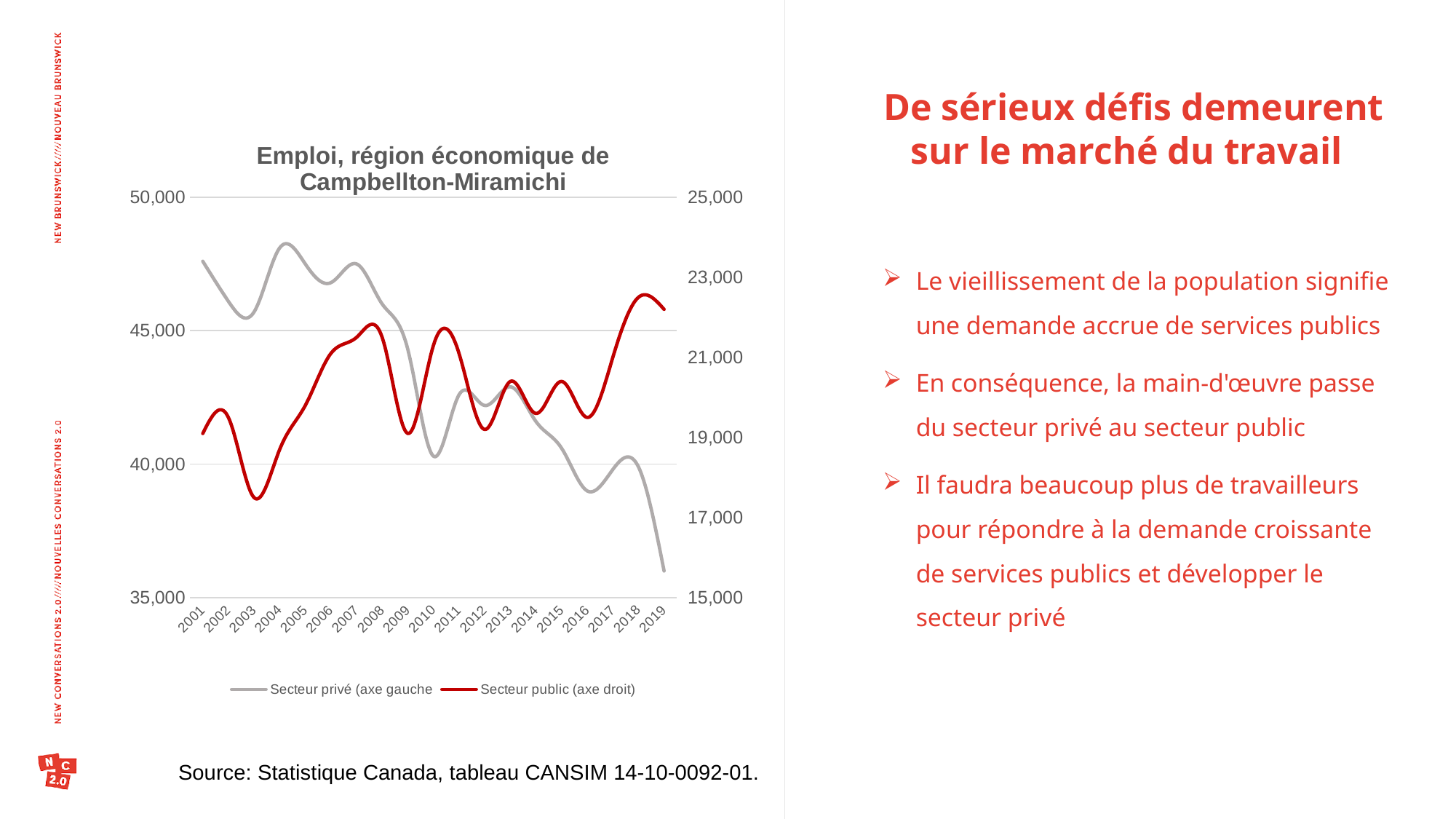
Does the Secteur public series overall rise or fall from 2001 to 2019? rise Which series is plotted against the right axis according to the legend? Secteur public (axe droit) In which year is the Secteur privé series at its lowest? 2019 What kind of chart is shown on the slide? line chart Is the Secteur privé value for 2019 greater or less than 40,000? less In which year is the Secteur privé series at its highest? 2004 How many years are plotted along the x axis? 19 In which year is the Secteur public series at its lowest? 2003 Does the Secteur privé series overall rise or fall from 2001 to 2019? fall How many series does the legend list? 2 What is the title of the chart? Emploi, région économique de Campbellton-Miramichi Is the Secteur public value for 2018 greater or less than 21,000? greater